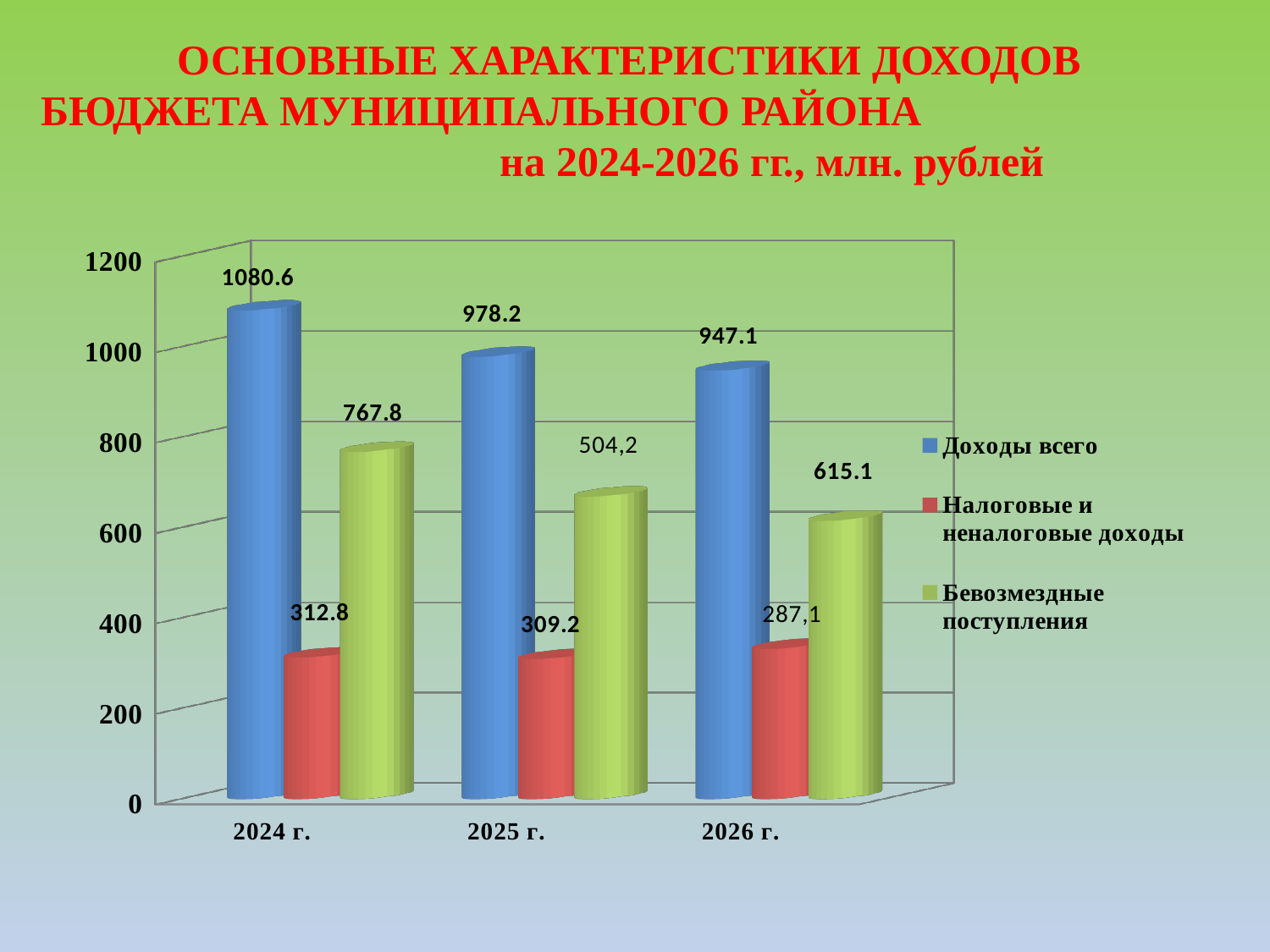
How many series does the legend list? 3 What is the value of Доходы всего for 2024 г.? 1080.6 What is the value of Налоговые и неналоговые доходы for 2026 г.? 287,1 What is the difference between Доходы всего in 2024 г. and 2025 г.? 102.4 What is the value of Безвозмездные поступления for 2026 г.? 615.1 Which is larger: Безвозмездные поступления in 2024 г. or in 2026 г.? 2024 г. What is the value of Безвозмездные поступления for 2025 г.? 504,2 In which year is Доходы всего the highest? 2024 г. How many years are shown on the x axis? 3 Is the value of Доходы всего for 2026 г. greater or less than 1000? less Does Доходы всего rise or fall from 2024 г. to 2026 г.? fall